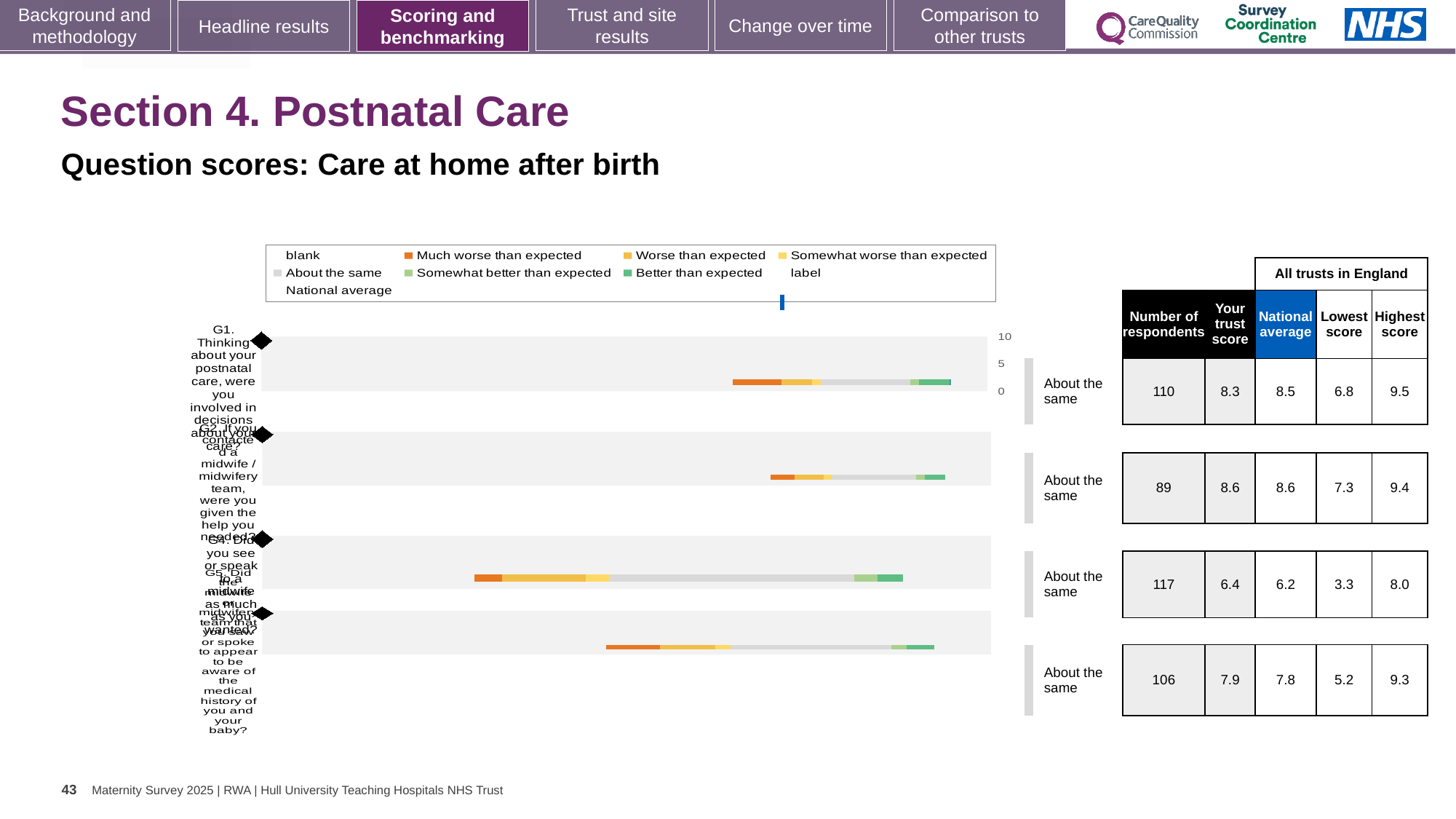
For the fourth row of the table, which is larger: your trust score or the national average? Your trust score (7.9) What is 'Your trust score' for the second row (G2, given the help you needed)? 8.6 What is the lowest 'Your trust score' shown in the table? 6.4 For the first row (G1), what is the difference between the highest score and the lowest score across all trusts in England? 2.7 What is the subtitle describing the question scores on this slide? Question scores: Care at home after birth How many question bars are plotted in the chart? 4 What is the national average for the third row of the table? 6.2 In the table beside the chart, what is the number of respondents for the first row (G1, involved in decisions about your care)? 110 How many more respondents answered the first row question than the second row question? 21 Which row of the table has the highest number of respondents? The third row (117) What kind of chart is shown on the slide? Bar chart What benchmark category is shown for every question on this slide? About the same